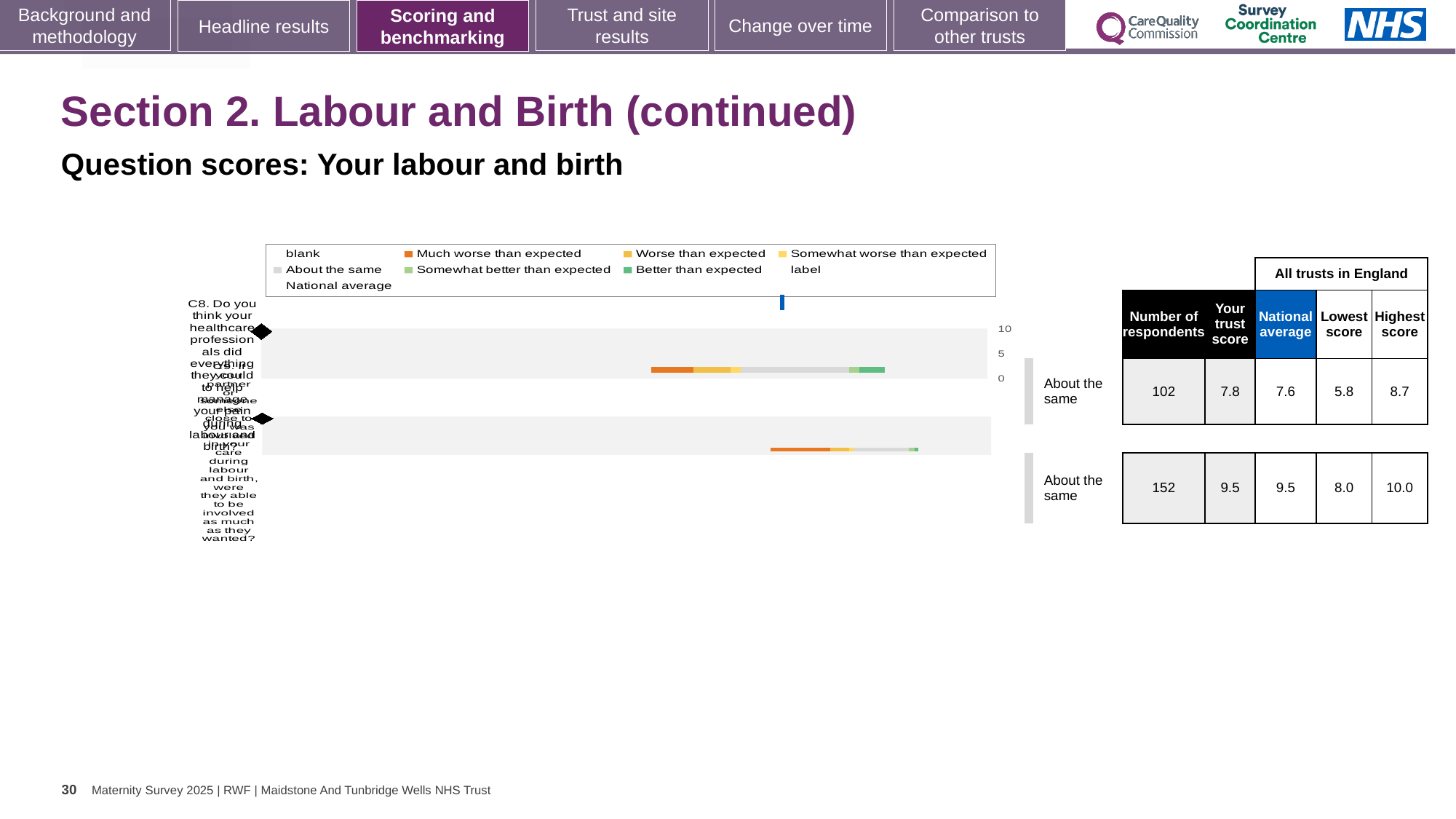
What is the lowest score among all trusts in England shown in the first row of the table? 5.8 In the first row of the table, which is larger: the trust score or the national average? trust score What is the difference in the number of respondents between the second row and the first row of the table? 50 What is the highest score among all trusts in England shown in the second row of the table? 10.0 What is the difference between the highest score and the lowest score in the first row of the table? 2.9 What benchmark label is shown next to both questions on the slide? About the same In the table, how many respondents are listed in the first row (question C8)? 102 What is the trust score shown in the first row of the table? 7.8 In the table, how many respondents are listed in the second row? 152 What colour represents 'Much worse than expected' in the chart legend? orange What is the national average shown in the first row of the table? 7.6 What kind of chart is shown on the slide? bar chart